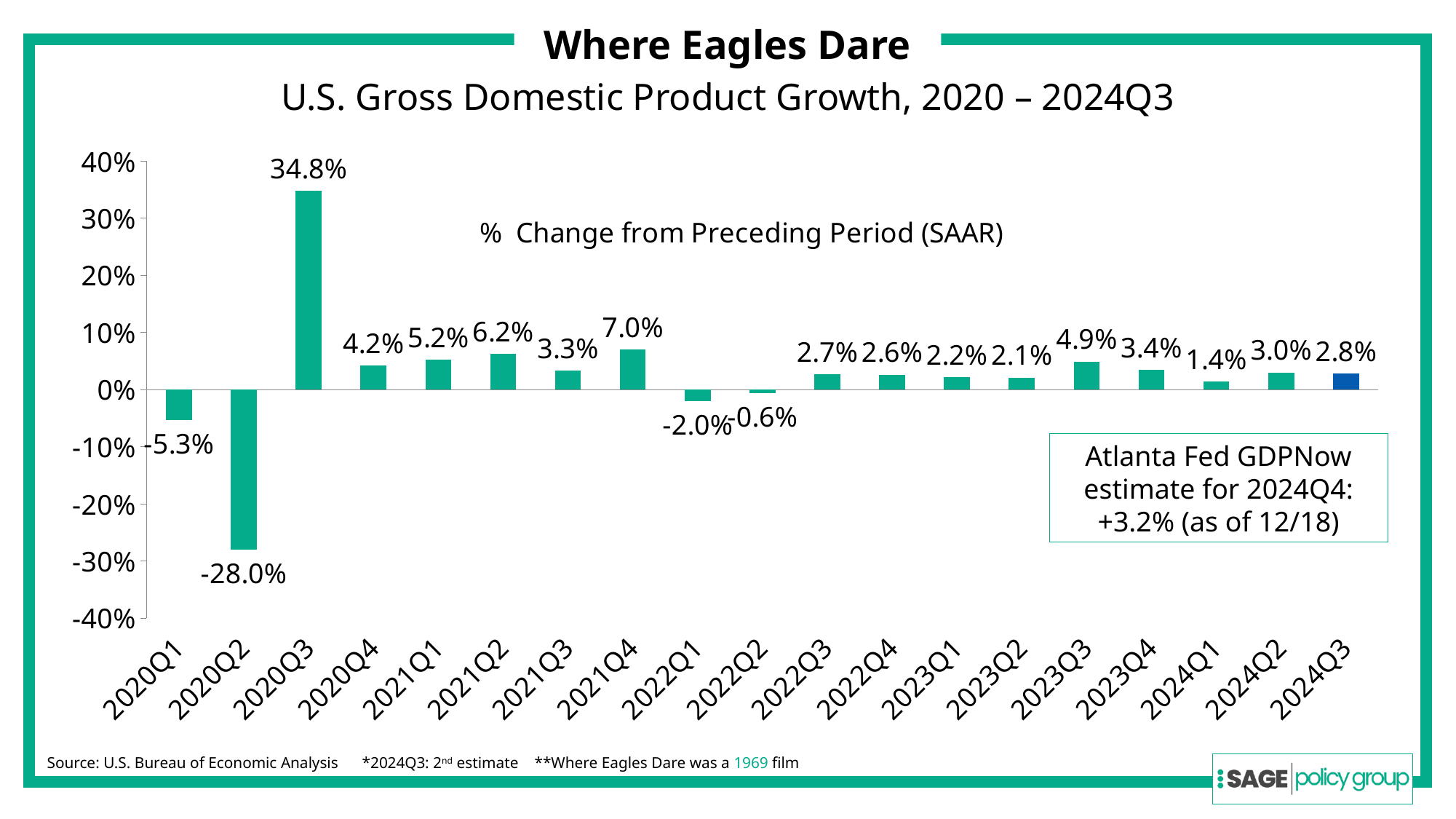
Which quarter has the lowest GDP growth? 2020Q2 What is the Atlanta Fed GDPNow estimate for 2024Q4 shown in the text box? +3.2% What is the difference between the GDP growth values for 2021Q4 and 2021Q3? 3.7% What is the GDP growth value for 2020Q2? -28.0% What kind of chart is shown on the slide? bar chart What is the GDP growth value for 2020Q3? 34.8% Which quarter has the highest GDP growth? 2020Q3 What is the GDP growth value for 2022Q1? -2.0% What is the GDP growth value for 2024Q3? 2.8% How many quarters are shown on the x axis? 19 Is the value for 2020Q3 greater or less than 30%? greater Which quarter has the larger GDP growth, 2023Q3 or 2023Q4? 2023Q3